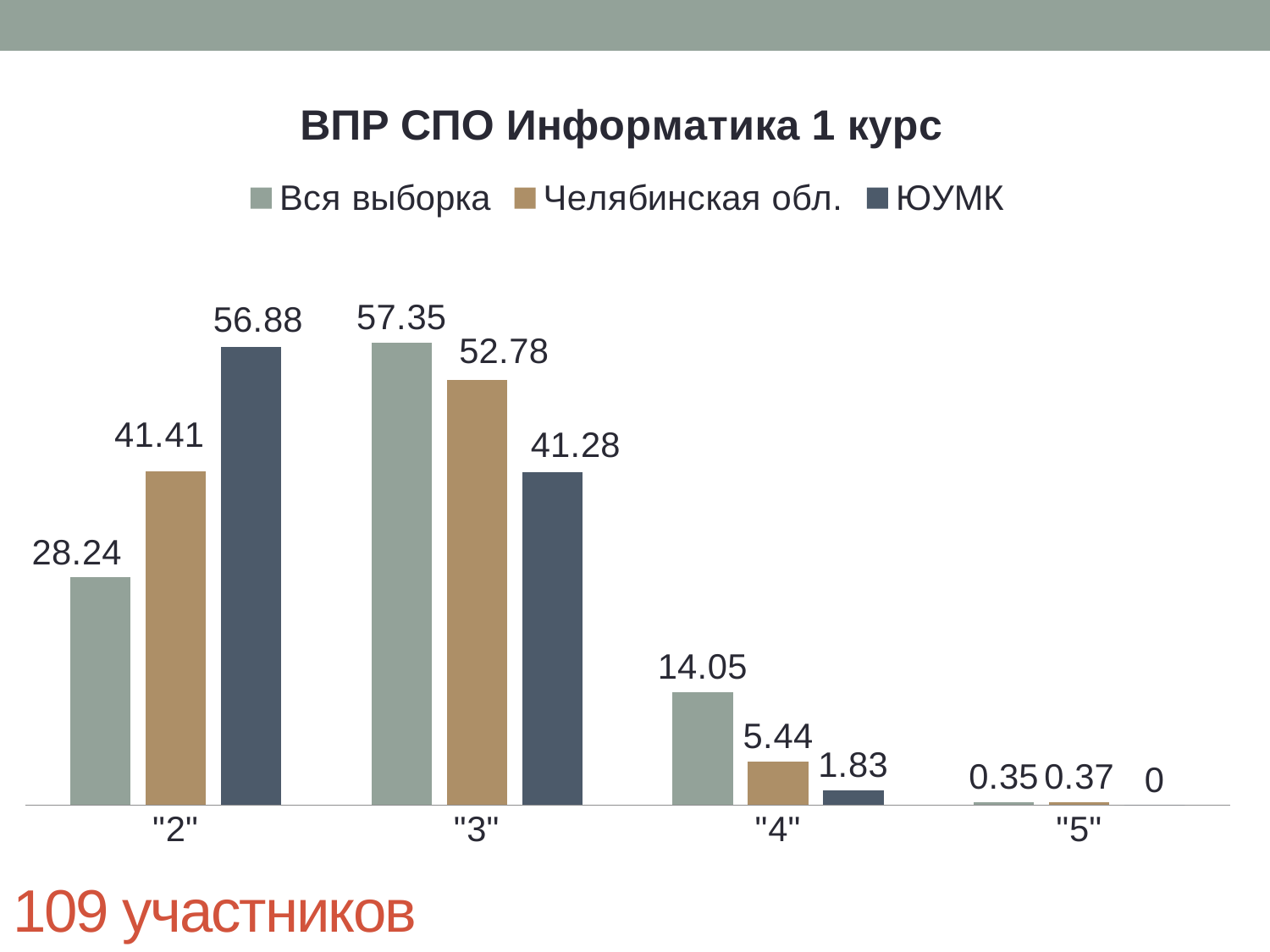
Which category has the lowest value for Вся выборка? "5" What is the value for ЮУМК in category "5"? 0 How many categories are shown on the x axis? 4 What is the value for Челябинская обл. in category "4"? 5.44 Which is larger in category "3": Челябинская обл. or ЮУМК? Челябинская обл. What is the difference between the ЮУМК and Вся выборка values in category "2"? 28.64 What is the value for Вся выборка in category "3"? 57.35 What is the value for ЮУМК in category "2"? 56.88 How many series does the legend list? 3 What is the title of the chart? ВПР СПО Информатика 1 курс What kind of chart is shown? bar chart Which category has the highest value for Челябинская обл.? "3"